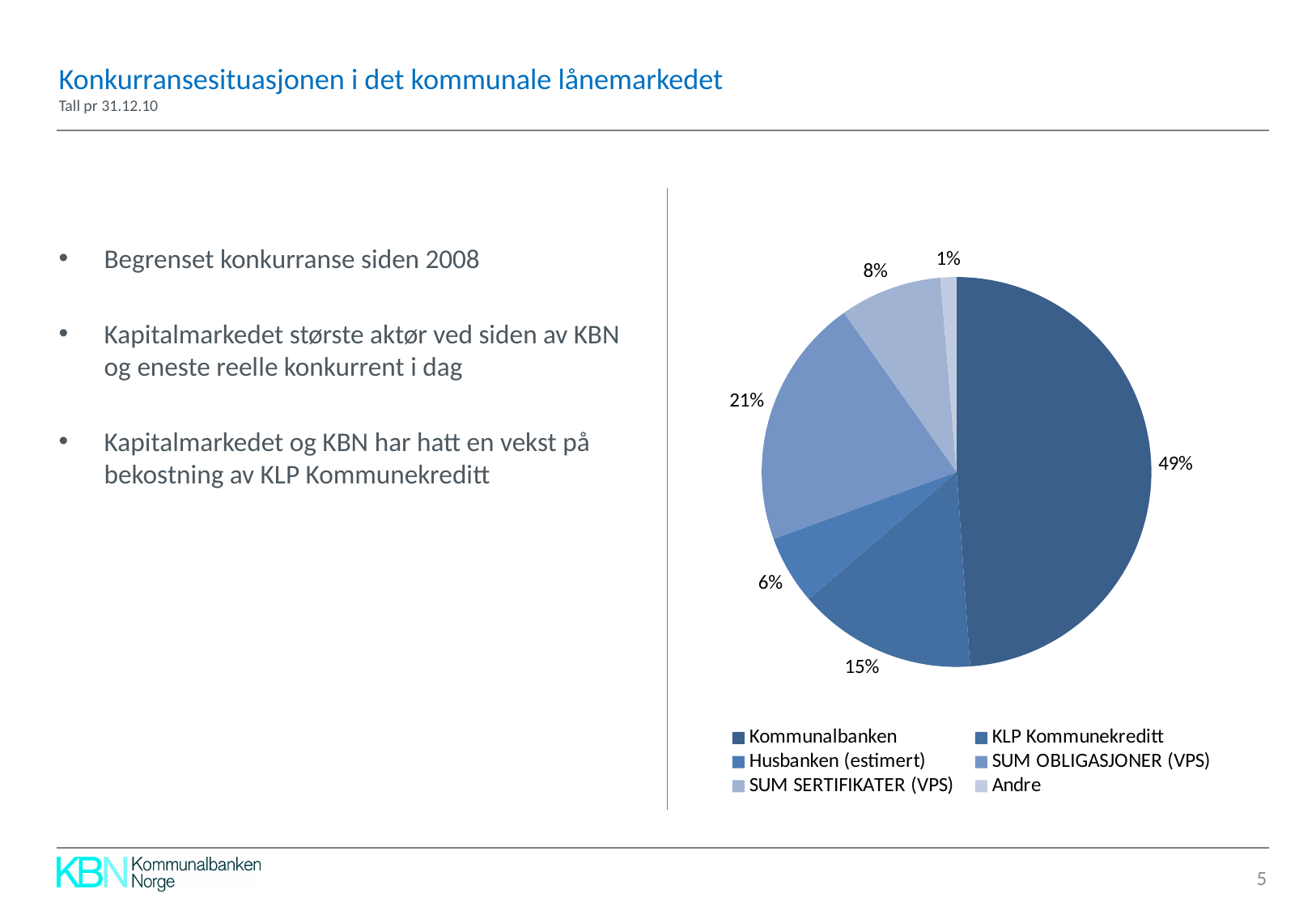
What share of the pie does SUM OBLIGASJONER (VPS) hold? 21% Which is larger, the share for KLP Kommunekreditt or the share for SUM SERTIFIKATER (VPS)? KLP Kommunekreditt How many slices does the pie chart have? 6 How many entries does the legend list? 6 Which category has the smallest slice of the pie? Andre What share of the pie does KLP Kommunekreditt hold? 15% Which category has the largest slice of the pie? Kommunalbanken What is the difference in percentage points between Kommunalbanken and SUM OBLIGASJONER (VPS)? 28 What kind of chart is shown on the slide? pie chart What share of the pie does SUM SERTIFIKATER (VPS) hold? 8% What share of the pie does Kommunalbanken hold? 49% What share of the pie does Husbanken (estimert) hold? 6%